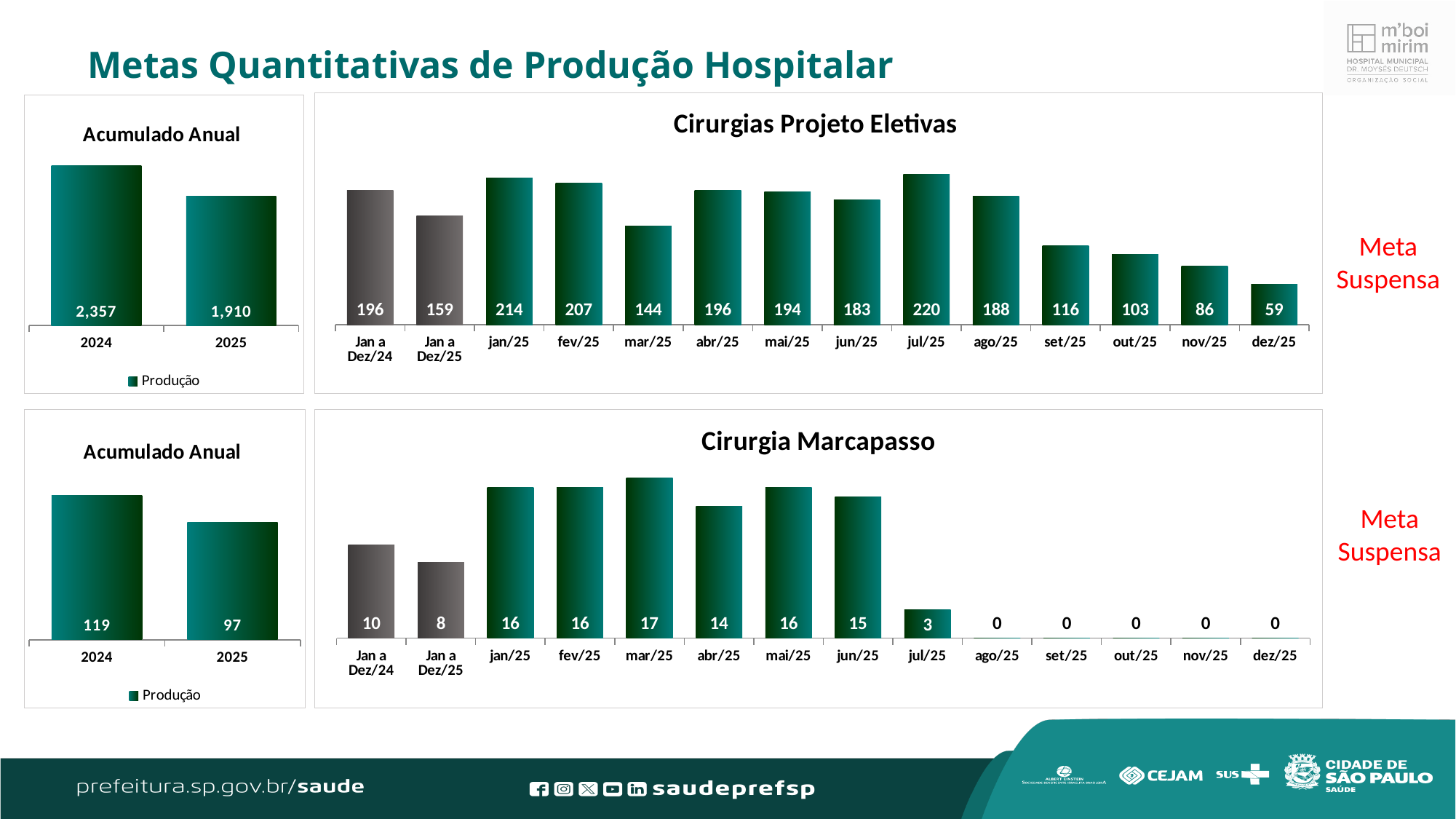
In the Cirurgia Marcapasso chart, how many months of 2025 show a value of 0? 5 In the Cirurgias Projeto Eletivas chart, what is the difference between the Jan a Dez/24 and Jan a Dez/25 values? 37 In the top-left Acumulado Anual chart, what is the value for 2024? 2,357 In the Cirurgias Projeto Eletivas chart, what is the value for jul/25? 220 What type of chart is the Cirurgias Projeto Eletivas chart? Bar chart In the bottom-left Acumulado Anual chart, which year has the larger value, 2024 or 2025? 2024 In the Cirurgias Projeto Eletivas chart, how many bars are plotted? 14 In the Cirurgia Marcapasso chart, what is the value for mar/25? 17 In the top-left Acumulado Anual chart, what is the difference between the 2024 and 2025 values? 447 In the Cirurgias Projeto Eletivas chart, which month of 2025 has the lowest value? dez/25 In the bottom-left Acumulado Anual chart, what is the value for 2025? 97 In the Cirurgia Marcapasso chart, which month of 2025 has the highest value? mar/25